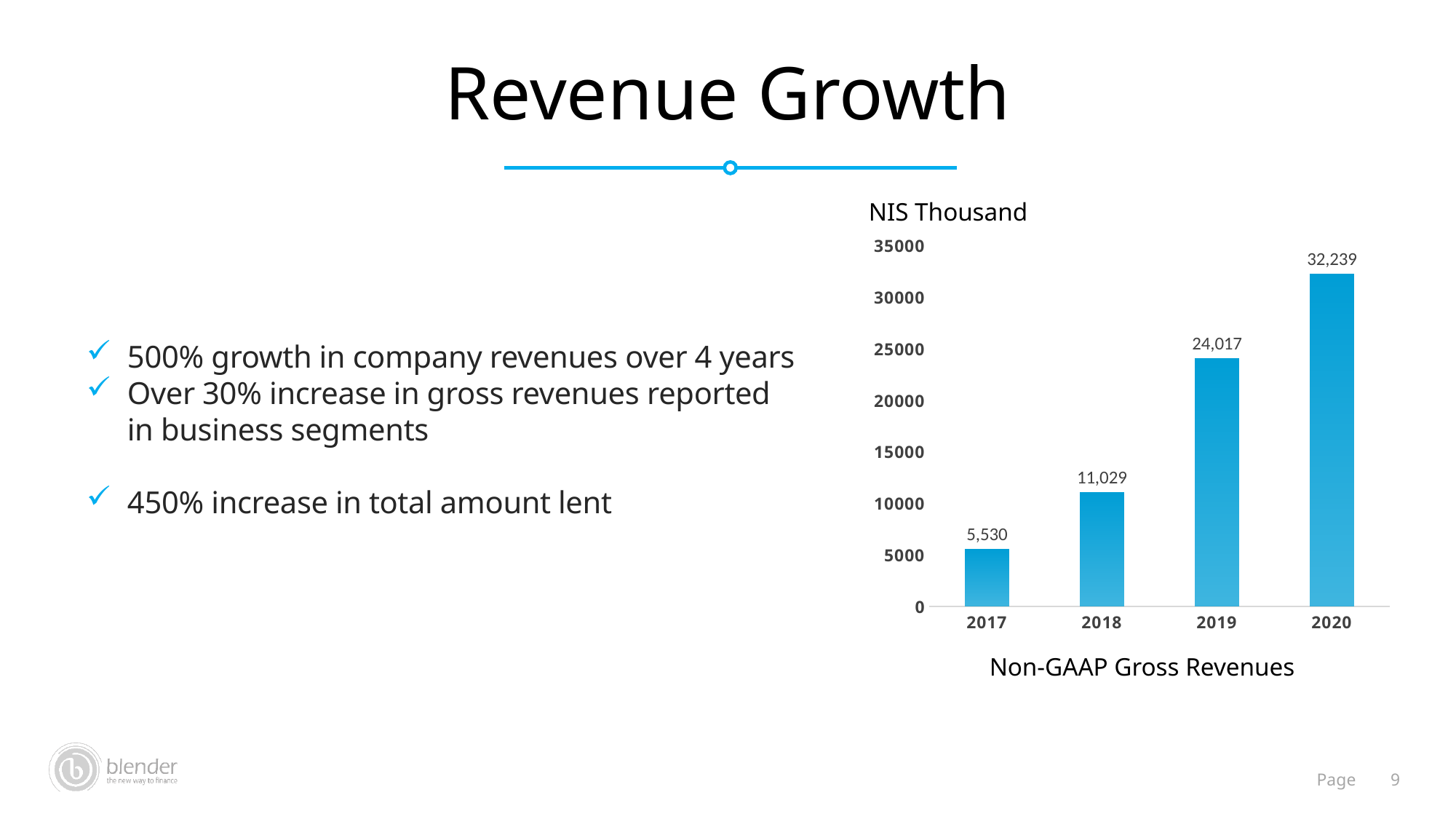
What is the Non-GAAP Gross Revenues value for 2017? 5,530 Is the value for 2018 greater or less than 10000? greater What is the Non-GAAP Gross Revenues value for 2018? 11,029 Which year has the highest Non-GAAP Gross Revenues? 2020 What is the Non-GAAP Gross Revenues value for 2020? 32,239 What is the difference between the 2020 and 2019 Non-GAAP Gross Revenues values? 8,222 Do the Non-GAAP Gross Revenues values rise or fall from 2017 to 2020? Rise What kind of chart is shown on the slide? Bar chart Which year has the lowest Non-GAAP Gross Revenues? 2017 Which year has the larger Non-GAAP Gross Revenues value, 2018 or 2019? 2019 What is the Non-GAAP Gross Revenues value for 2019? 24,017 How many years are shown on the x axis of the chart? 4